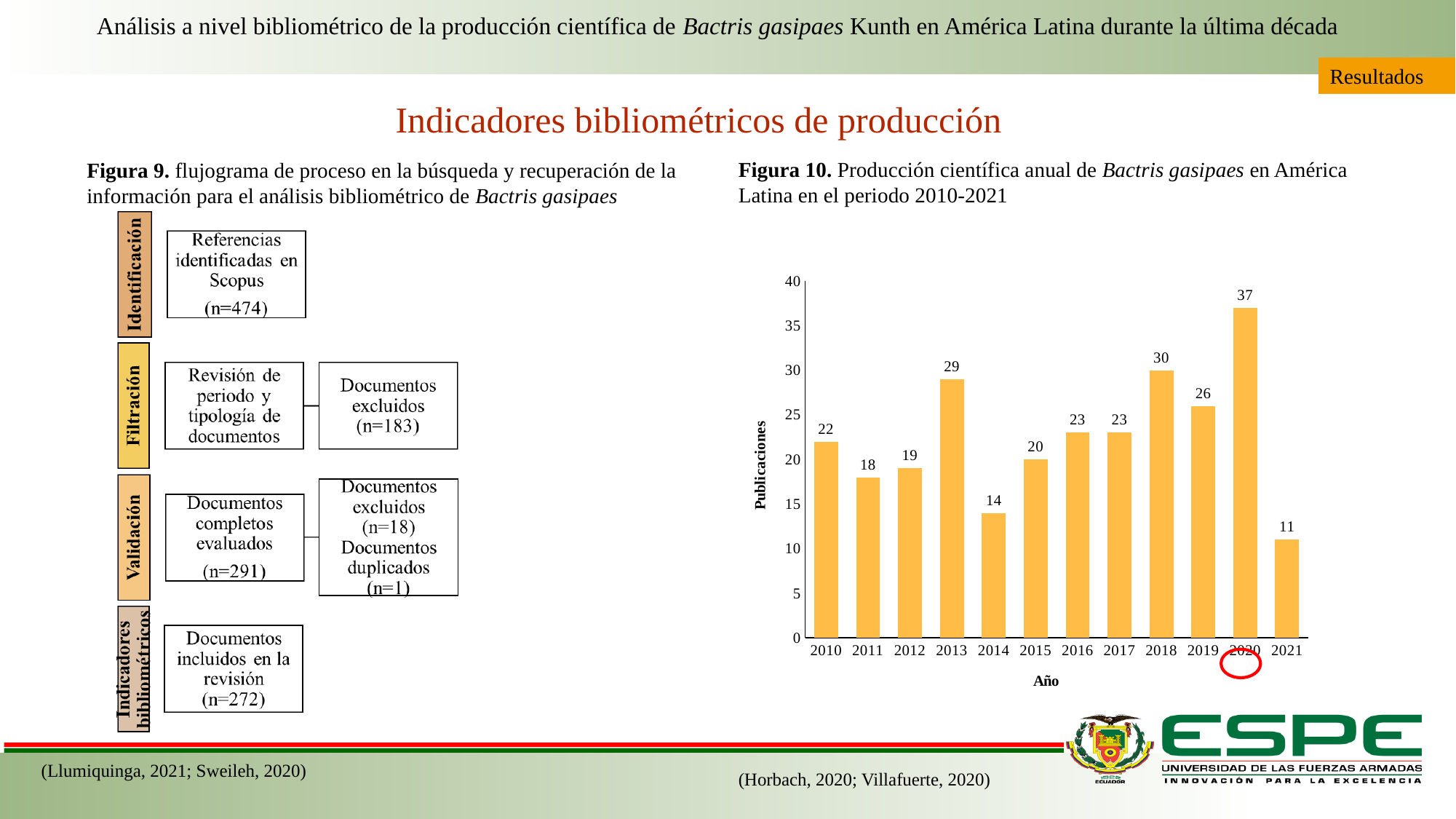
In Figura 10, which year has the lowest number of publications? 2021 In Figura 10, how many publications were there in 2013? 29 In Figura 10, which year had more publications, 2015 or 2018? 2018 In Figura 10, what is the label of the y axis? Publicaciones In Figura 10, what is the value for 2021? 11 In Figura 10, what is the difference in publications between 2020 and 2019? 11 In Figura 10, is the value for 2014 greater or less than 15? less In Figura 10, what is the label of the x axis? Año What type of chart is Figura 10? bar chart In Figura 10, which year has the highest number of publications? 2020 In Figura 10, how many years are shown on the x axis? 12 In Figura 10, do the values rise or fall from 2017 to 2020? rise